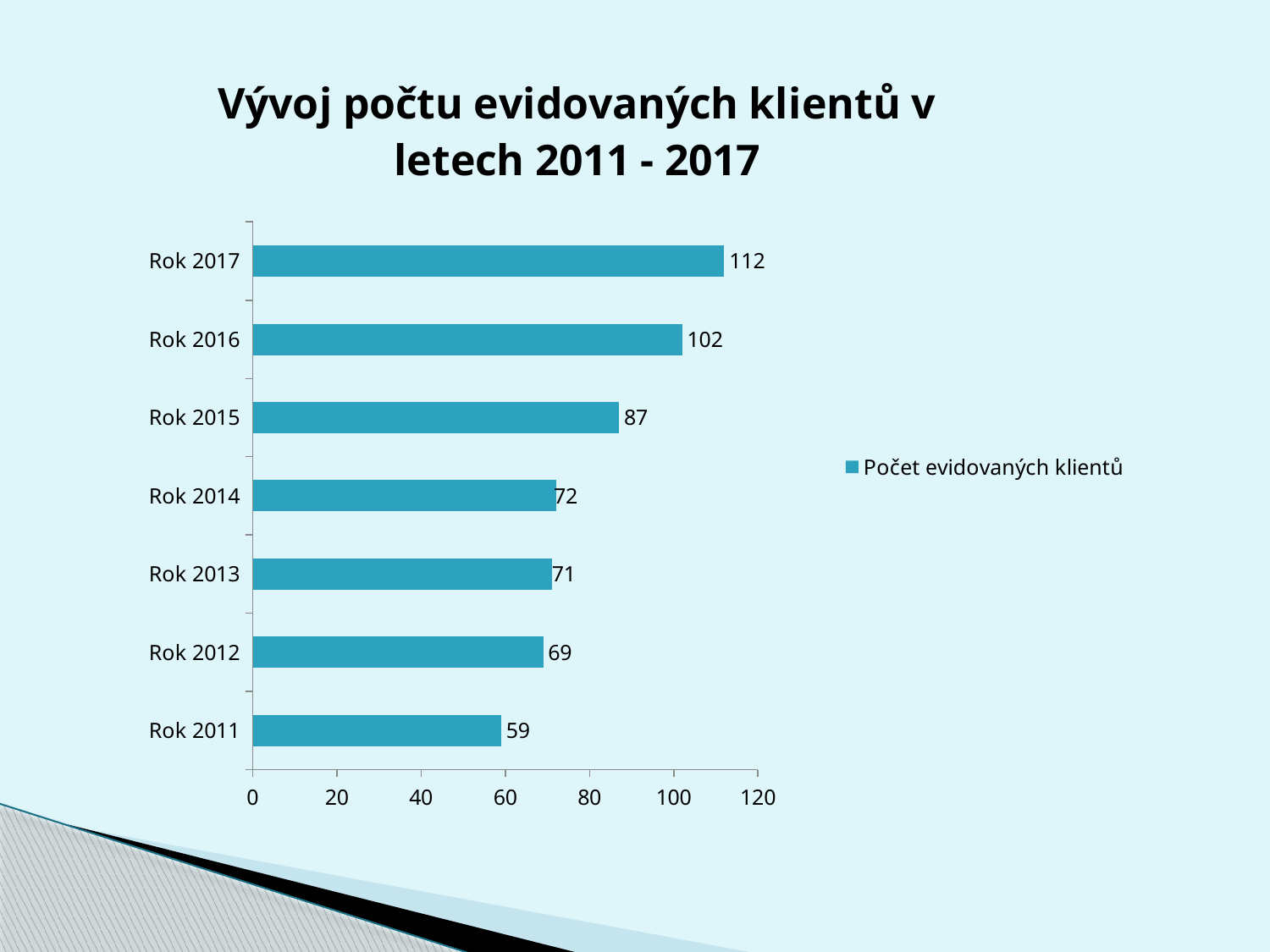
How many years are shown on the chart? 7 What kind of chart is shown on the slide? bar chart What is the value for Rok 2017? 112 What series name does the legend show? Počet evidovaných klientů Which year has the highest number of registered clients? Rok 2017 What is the difference between the values for Rok 2017 and Rok 2011? 53 What is the value for Rok 2011? 59 What is the difference between the values for Rok 2016 and Rok 2015? 15 Which year has the lowest number of registered clients? Rok 2011 Is the value for Rok 2016 greater or less than 100? greater What is the value for Rok 2013? 71 Which is larger, the value for Rok 2015 or the value for Rok 2014? Rok 2015